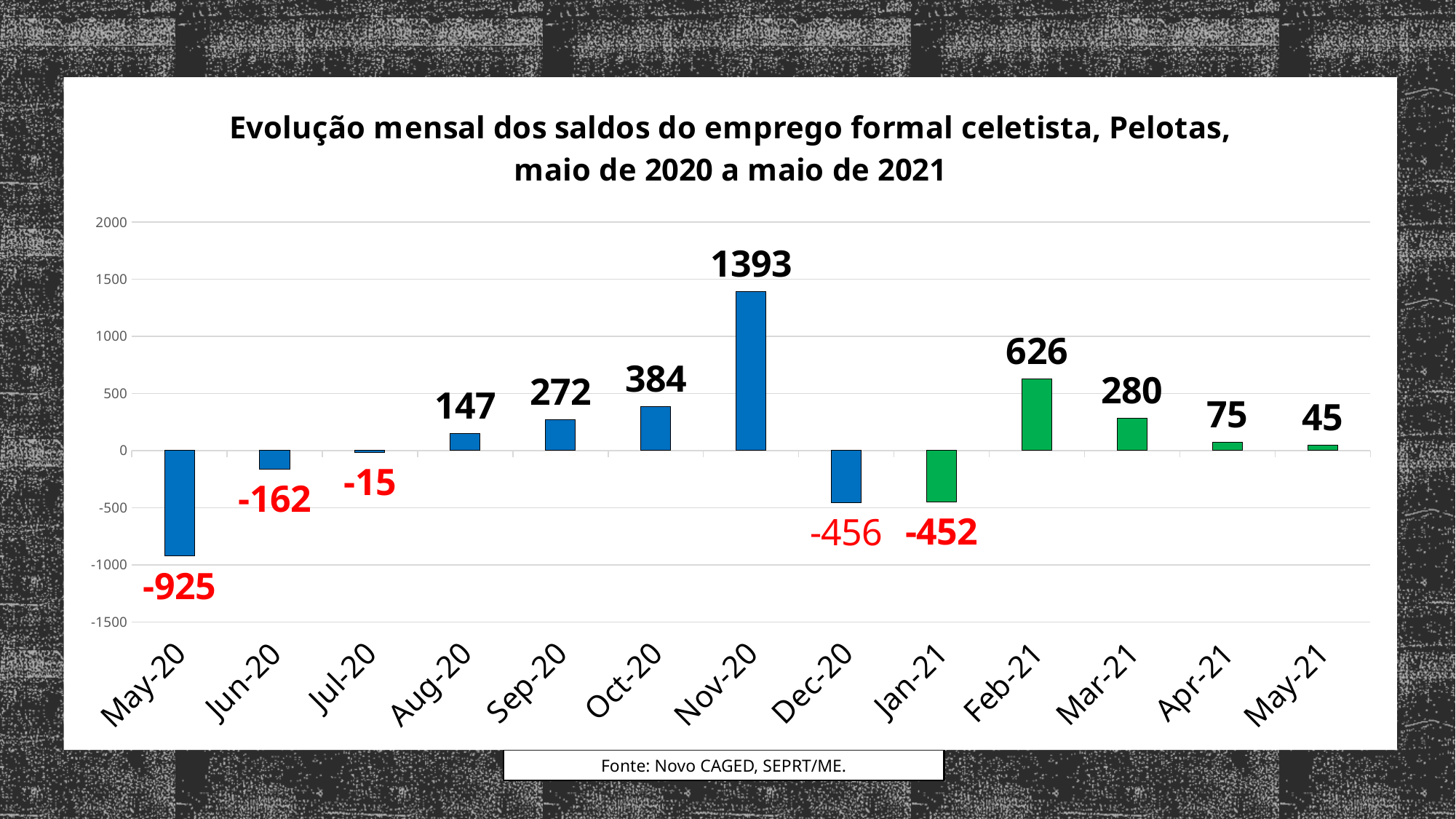
What is the source cited below the chart? Novo CAGED, SEPRT/ME. What is the difference between the values for Nov-20 and Feb-21? 767 What is the value for Nov-20? 1393 What is the value for May-20? -925 Which month has the highest value? Nov-20 What kind of chart is this? Bar chart How many months are shown on the x axis? 13 What is the value for Feb-21? 626 Which month has the lowest value? May-20 What is the value for Jan-21? -452 Do the values rise or fall from Feb-21 to May-21? Fall Which is larger, the value for Sep-20 or the value for Mar-21? Mar-21